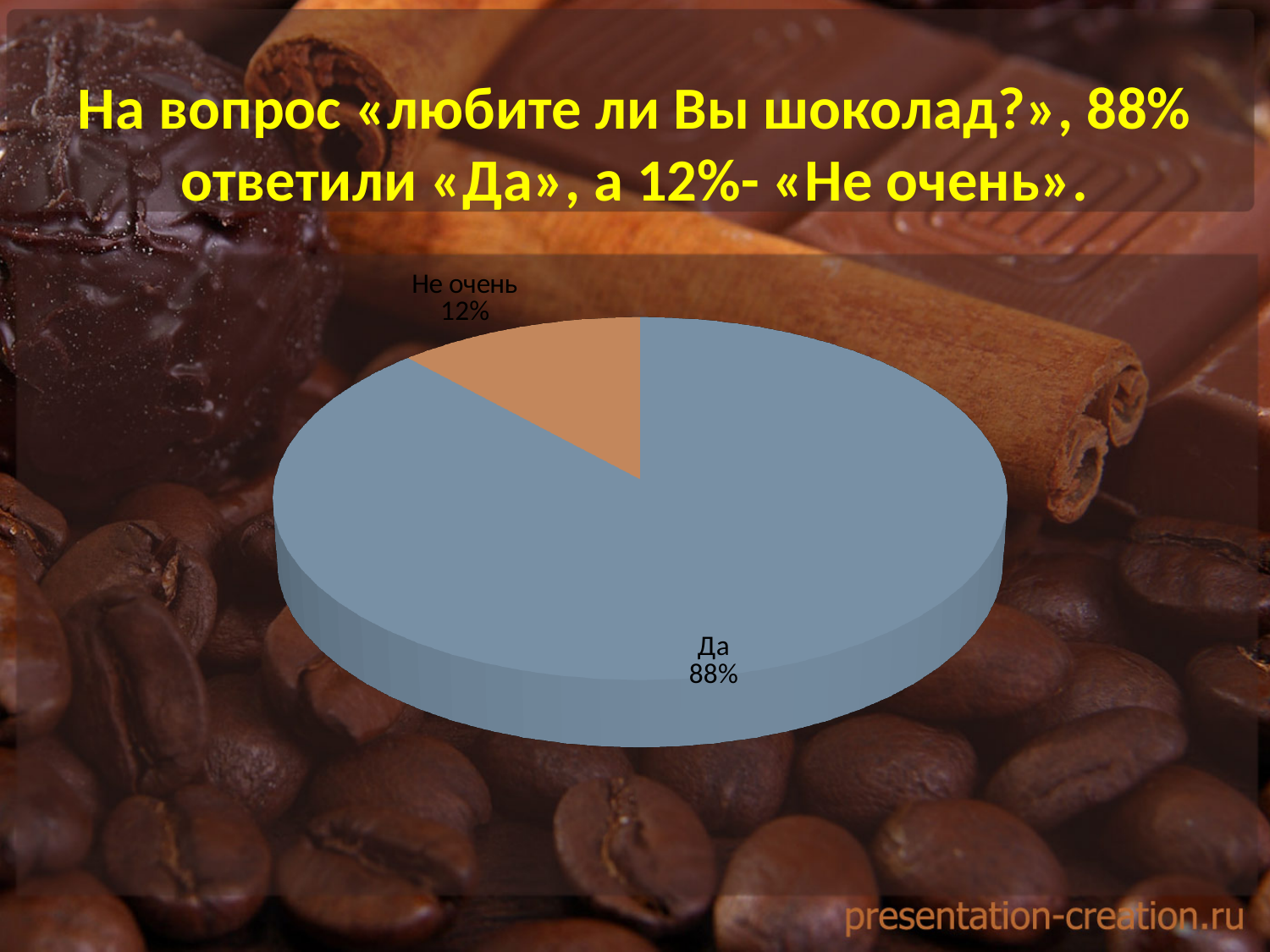
What share of the pie does the "Да" slice represent? 88% How many slices does the pie chart have? 2 What is the difference in percentage points between the "Да" and "Не очень" slices? 76 Which slice of the pie is the smallest? Не очень Which slice of the pie is the largest? Да What colour is the "Да" slice? blue-grey What share of the pie does the "Не очень" slice represent? 12% What colour is the "Не очень" slice? orange What kind of chart is shown on the slide? pie chart Which is larger, the "Да" slice or the "Не очень" slice? Да